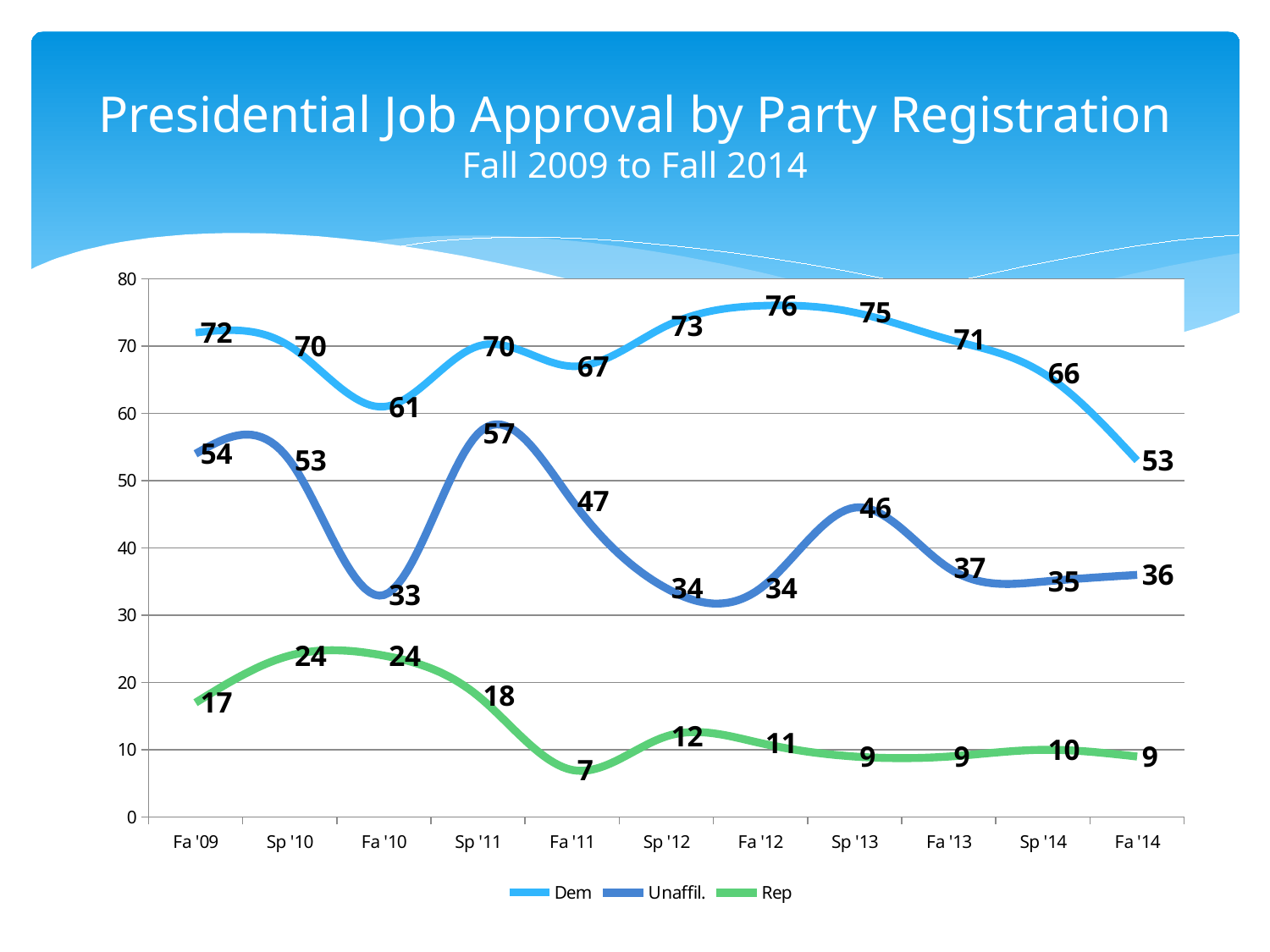
What kind of chart is shown on the slide? Line chart What is the Rep value for Fa '11? 7 What is the Unaffil. value for Sp '11? 57 What is the title of the chart? Presidential Job Approval by Party Registration Does the Dem series rise or fall from Sp '13 to Fa '14? Fall Which is larger, the Unaffil. value at Sp '13 or at Fa '13? Sp '13 How many x-axis points are plotted for each series? 11 What is the Dem value for Fa '12? 76 At which x-axis point is the Dem series lowest? Fa '14 At which x-axis point is the Rep series highest? Sp '10 and Fa '10 What is the difference between the Dem and Unaffil. values at Fa '14? 17 How many series does the legend list? 3